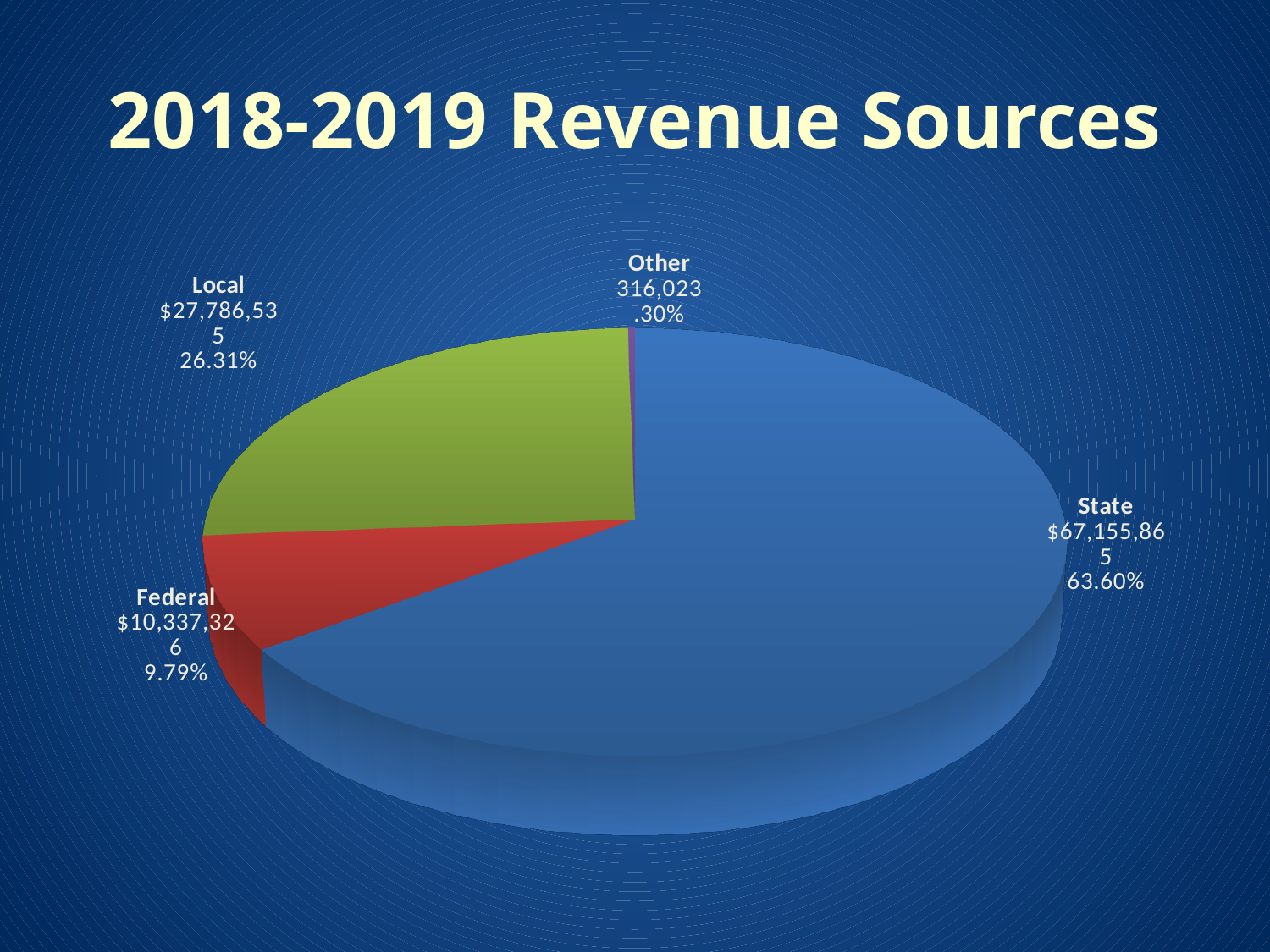
What colour is the State slice of the pie chart? Blue What is the difference in percentage share between State and Local revenue? 37.29% Which revenue source is the smallest? Other What is the dollar amount of Local revenue? $27,786,535 Which is larger, Local revenue or Federal revenue? Local Which revenue source is the largest? State What is the dollar amount of Federal revenue? $10,337,326 What percentage of revenue comes from Other sources? .30% How many revenue sources (slices) does the pie chart show? 4 What is the title of the chart? 2018-2019 Revenue Sources What type of chart is shown on the slide? Pie chart What percentage of revenue comes from State sources? 63.60%